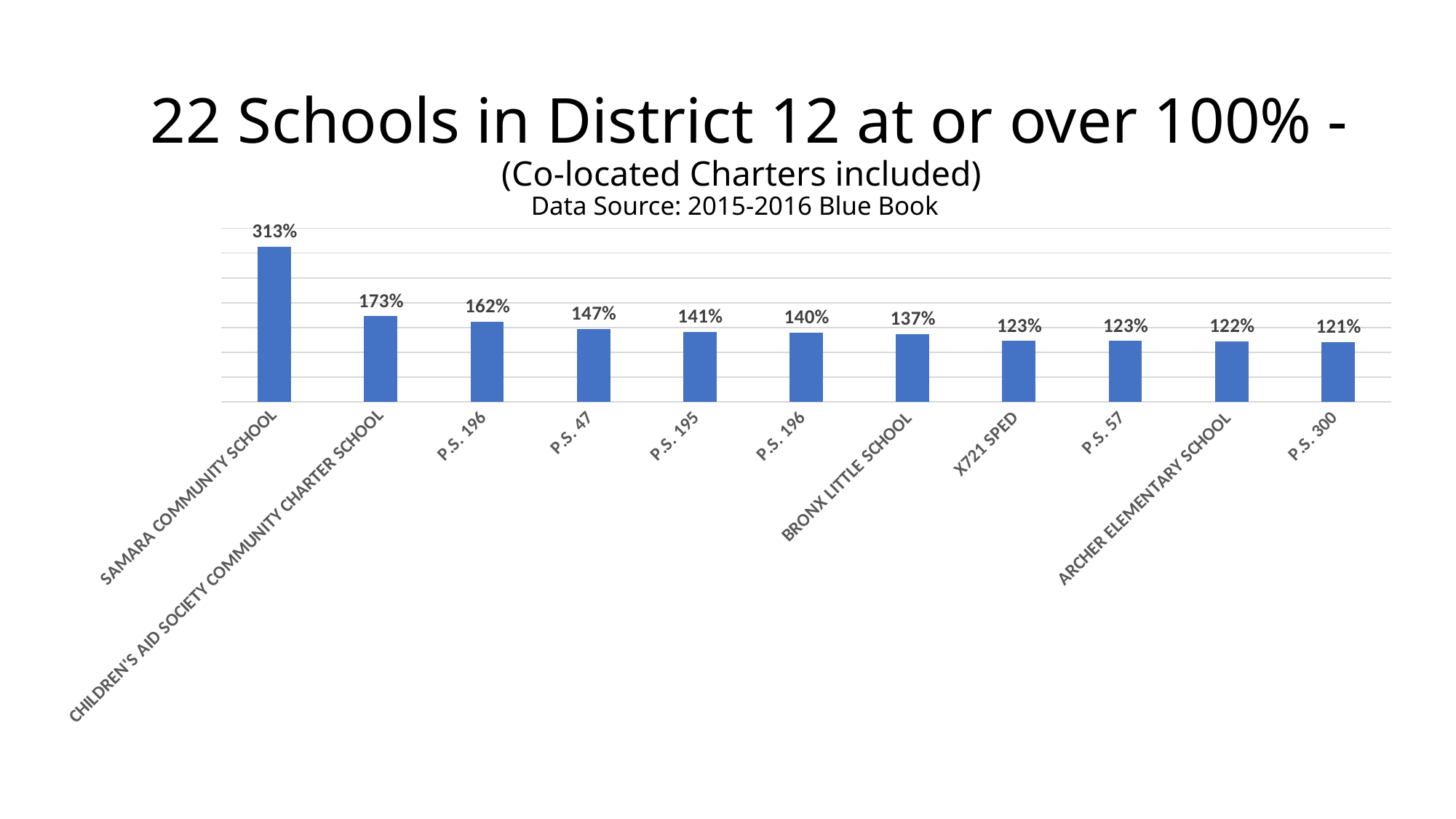
What is the value for Children's Aid Society Community Charter School? 173% What is the value for Bronx Little School? 137% Do the values rise or fall from left to right along the x axis? Fall What is the value for Samara Community School? 313% Which school has the lowest value in the chart? P.S. 300 How many bars are shown in the chart? 11 What is the difference between the values for Samara Community School and Children's Aid Society Community Charter School? 140% What kind of chart is shown on the slide? Bar chart Which is larger, the value for P.S. 47 or the value for Bronx Little School? P.S. 47 What is the difference between the values for P.S. 47 and P.S. 195? 6% Which school has the highest value in the chart? Samara Community School What is the value for Archer Elementary School? 122%